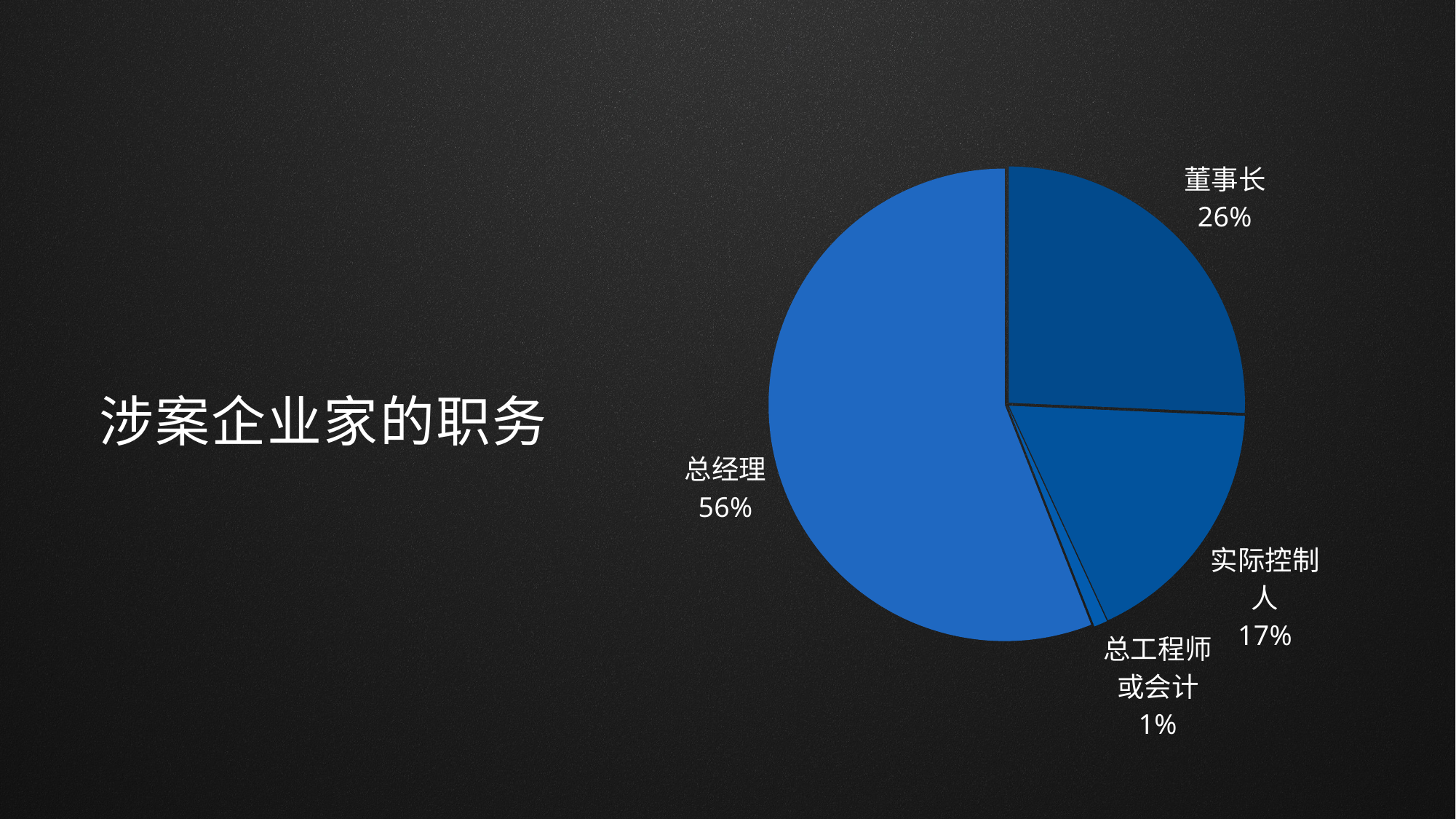
Which category has the largest slice of the pie? 总经理 Which category has the smallest slice of the pie? 总工程师或会计 What is the value shown for 董事长? 26% What is the title text on the slide? 涉案企业家的职务 What is the difference between the shares of 董事长 and 实际控制人? 9% What kind of chart is shown on the slide? Pie chart What is the value shown for 实际控制人? 17% How many categories are shown in the pie chart? 4 What is the difference between the shares of 总经理 and 董事长? 30% What share of the pie does 总经理 hold? 56% What is the value shown for 总工程师或会计? 1% Which is larger, the share of 董事长 or the share of 实际控制人? 董事长